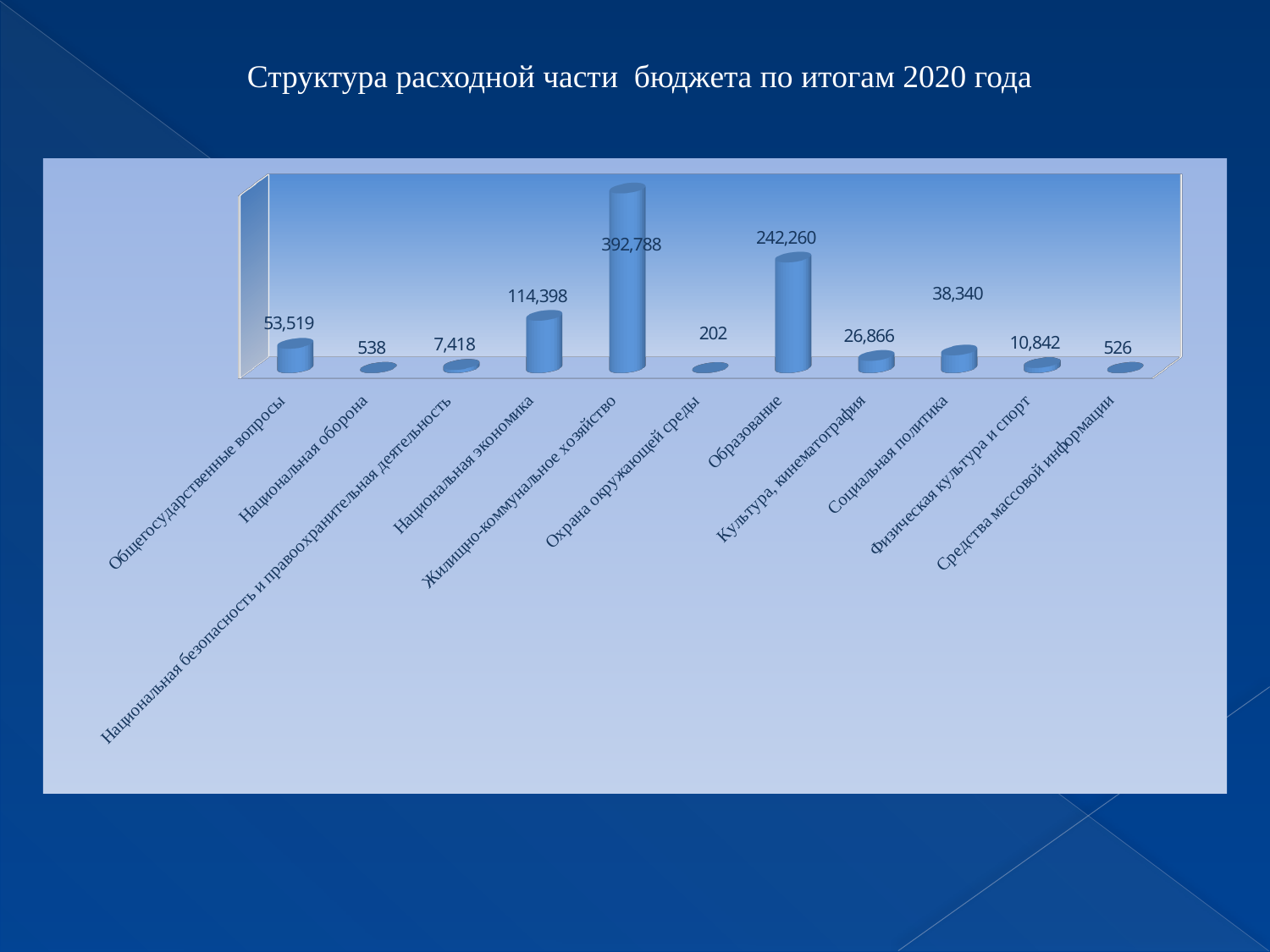
What is the difference between the values for Жилищно-коммунальное хозяйство and Образование? 150,528 How many categories are shown in the chart? 11 Which category has the lowest value? Охрана окружающей среды Which category has the highest value? Жилищно-коммунальное хозяйство What is the difference between the values for Национальная экономика and Общегосударственные вопросы? 60,879 What is the value for Жилищно-коммунальное хозяйство? 392,788 What is the value for Образование? 242,260 What is the title of the chart? Структура расходной части бюджета по итогам 2020 года What kind of chart is shown on the slide? Bar chart Which is larger, the value for Культура, кинематография or the value for Социальная политика? Социальная политика What is the value for Социальная политика? 38,340 What is the value for Охрана окружающей среды? 202